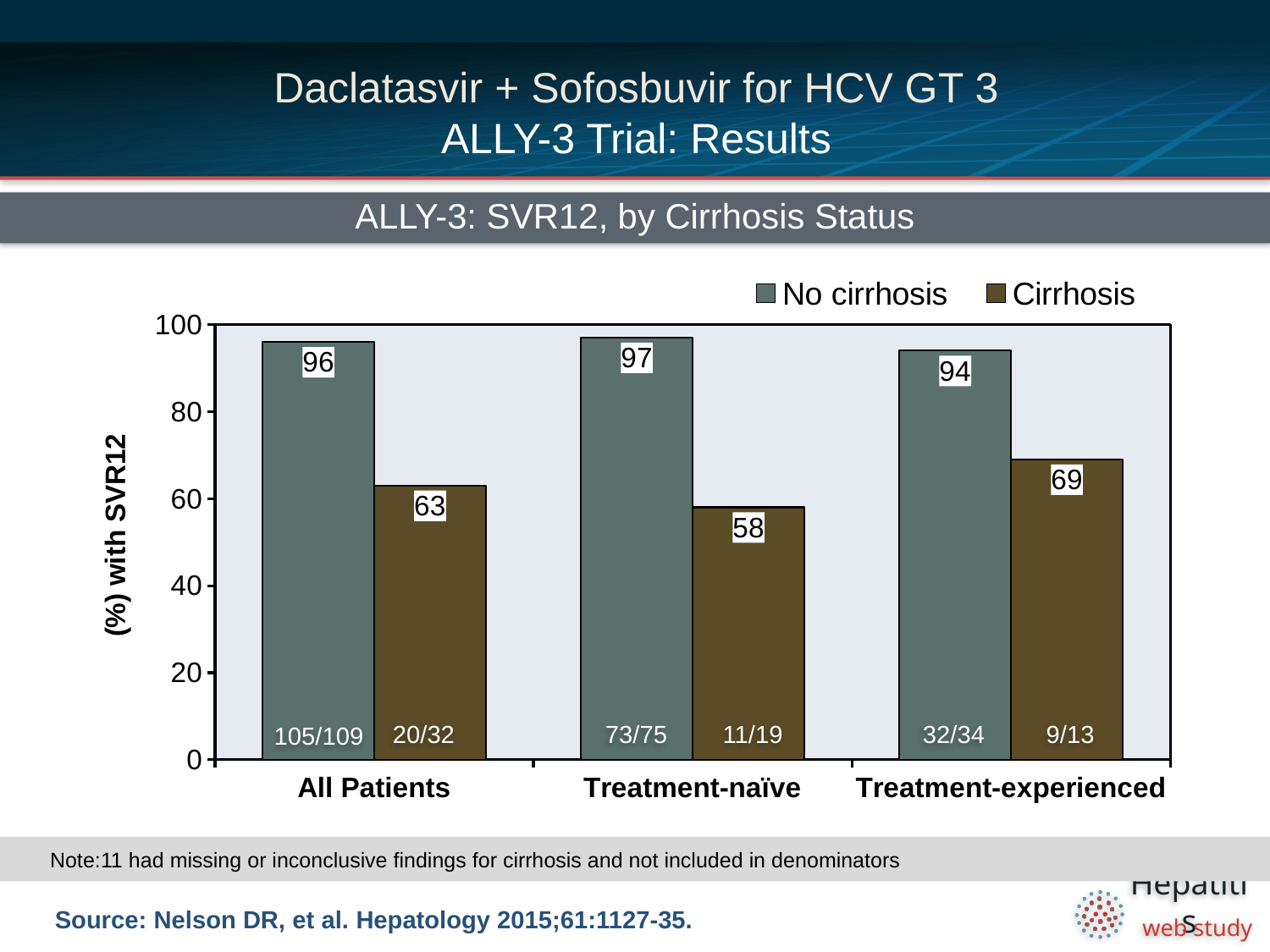
What is the SVR12 rate for patients with no cirrhosis in the All Patients group? 96 What is the title of the chart? ALLY-3: SVR12, by Cirrhosis Status Which group has the lowest SVR12 rate among patients with cirrhosis? Treatment-naïve What fraction of patients is shown for the No cirrhosis bar in the Treatment-naïve group? 73/75 How many series does the legend list? 2 What is the SVR12 rate for patients with cirrhosis in the Treatment-experienced group? 69 What is the SVR12 rate for patients with cirrhosis in the Treatment-naïve group? 58 What is the difference between the No cirrhosis and Cirrhosis SVR12 rates in the All Patients group? 33 What kind of chart is shown on the slide? Bar chart Which group has the highest SVR12 rate among patients with no cirrhosis? Treatment-naïve How many patient groups are shown on the x axis? 3 Which is larger: the Cirrhosis SVR12 rate for Treatment-experienced or for All Patients? Treatment-experienced